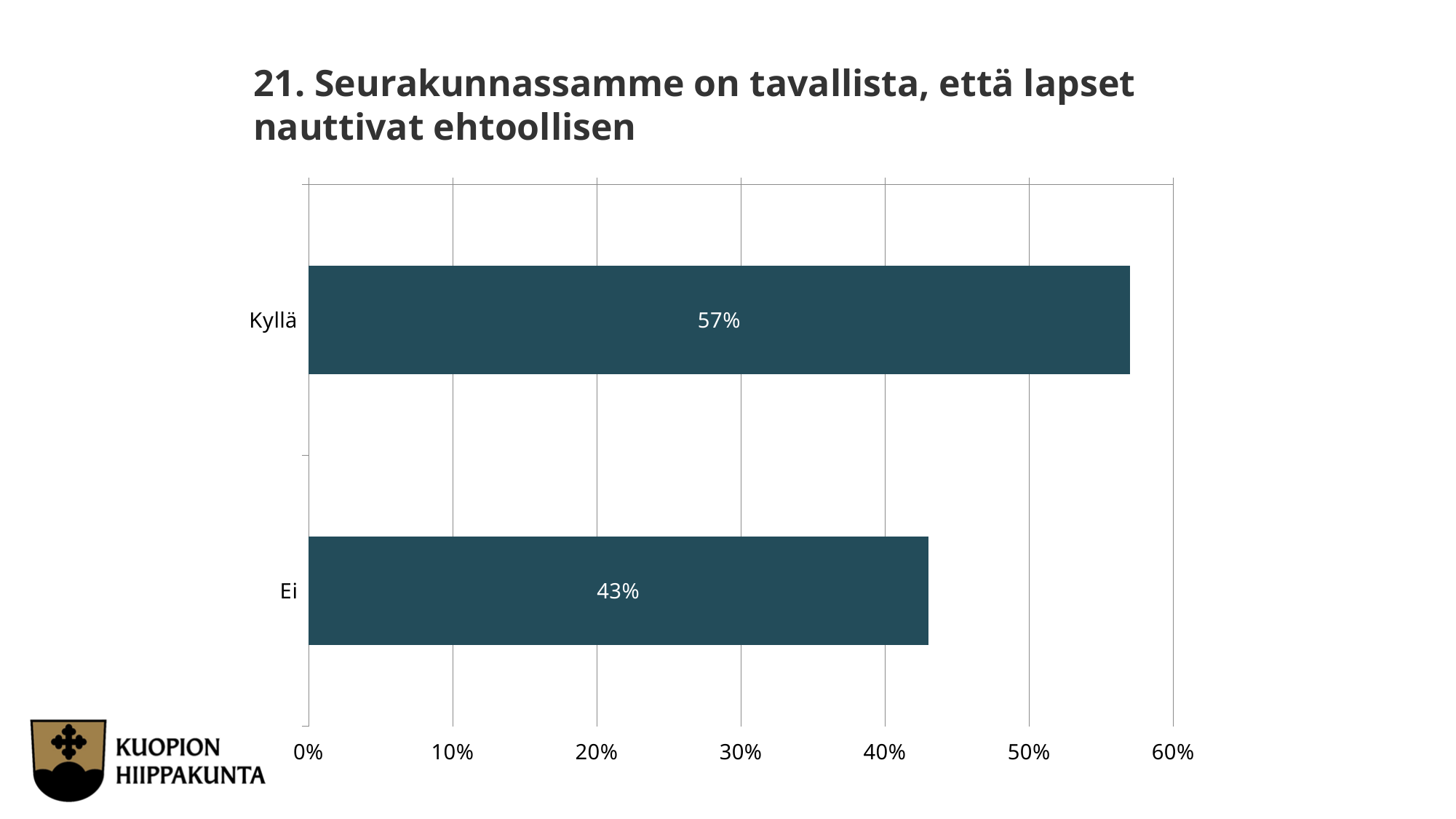
How many categories are shown in the chart? 2 What is the difference between the values for Kyllä and Ei? 14% Is the value for Kyllä greater or less than 50%? greater What is the title of the chart? 21. Seurakunnassamme on tavallista, että lapset nauttivat ehtoollisen Which category has the highest value? Kyllä What kind of chart is shown on the slide? bar chart What is the value for Ei? 43% Is the value for Ei greater or less than 50%? less What is the maximum value shown on the x axis? 60% Which is larger, the value for Kyllä or the value for Ei? Kyllä What is the value for Kyllä? 57% Which category has the lowest value? Ei